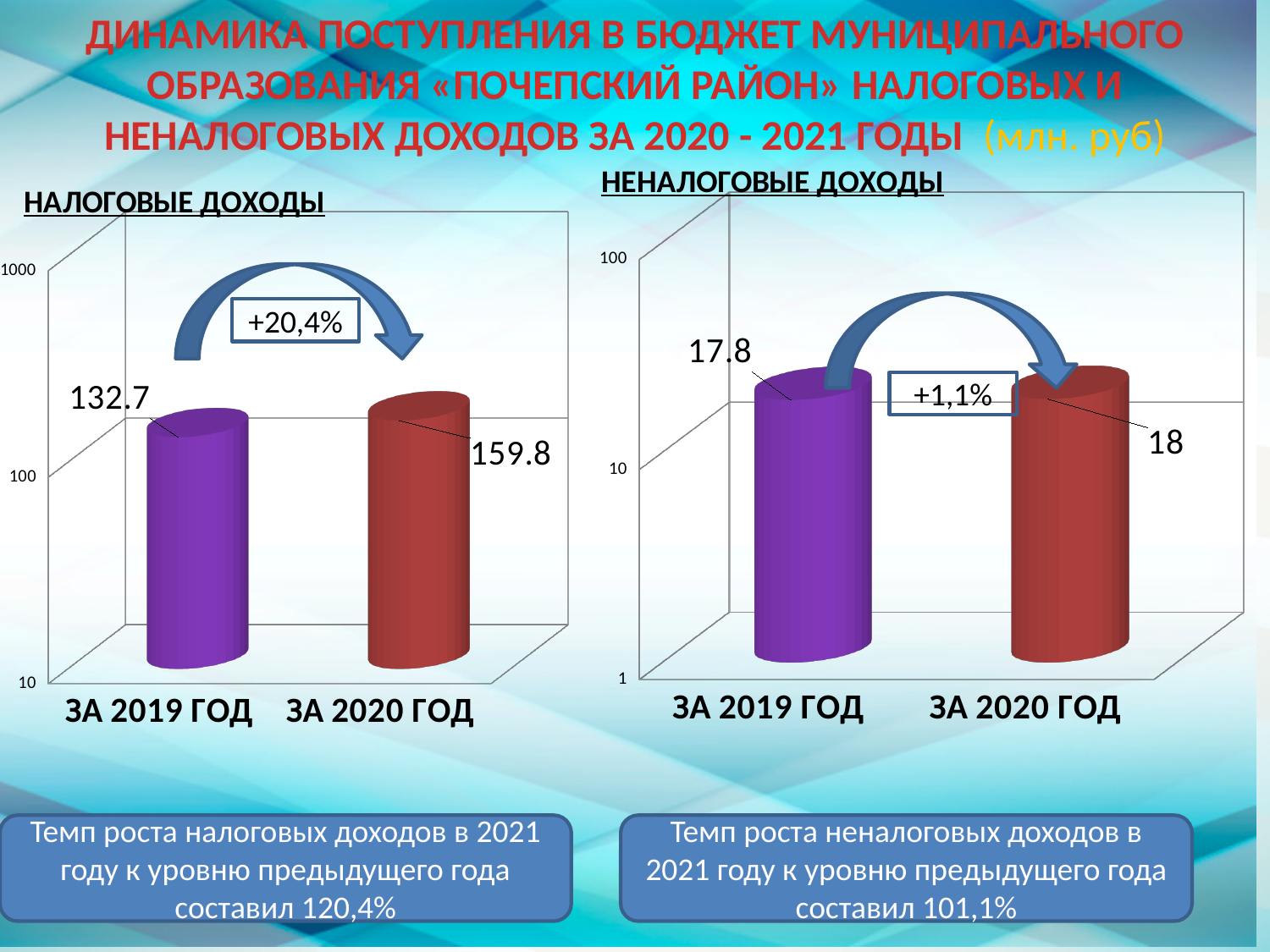
What percentage change is shown in the callout on the НЕНАЛОГОВЫЕ ДОХОДЫ chart? +1,1% How many categories are shown in the НЕНАЛОГОВЫЕ ДОХОДЫ chart? 2 In the НАЛОГОВЫЕ ДОХОДЫ chart, do the values rise or fall from ЗА 2019 ГОД to ЗА 2020 ГОД? rise In the НЕНАЛОГОВЫЕ ДОХОДЫ chart, what is the value for ЗА 2020 ГОД? 18 What kind of chart is the НАЛОГОВЫЕ ДОХОДЫ chart? bar chart In the НАЛОГОВЫЕ ДОХОДЫ chart, which category has the highest value? ЗА 2020 ГОД In the НЕНАЛОГОВЫЕ ДОХОДЫ chart, what is the difference between the values for ЗА 2020 ГОД and ЗА 2019 ГОД? 0.2 In the НАЛОГОВЫЕ ДОХОДЫ chart, what is the difference between the values for ЗА 2020 ГОД and ЗА 2019 ГОД? 27.1 In the НАЛОГОВЫЕ ДОХОДЫ chart, what is the value for ЗА 2020 ГОД? 159.8 In the НАЛОГОВЫЕ ДОХОДЫ chart, what is the value for ЗА 2019 ГОД? 132.7 In the НЕНАЛОГОВЫЕ ДОХОДЫ chart, what is the value for ЗА 2019 ГОД? 17.8 In the НАЛОГОВЫЕ ДОХОДЫ chart, is the value for ЗА 2019 ГОД greater or less than 100? greater